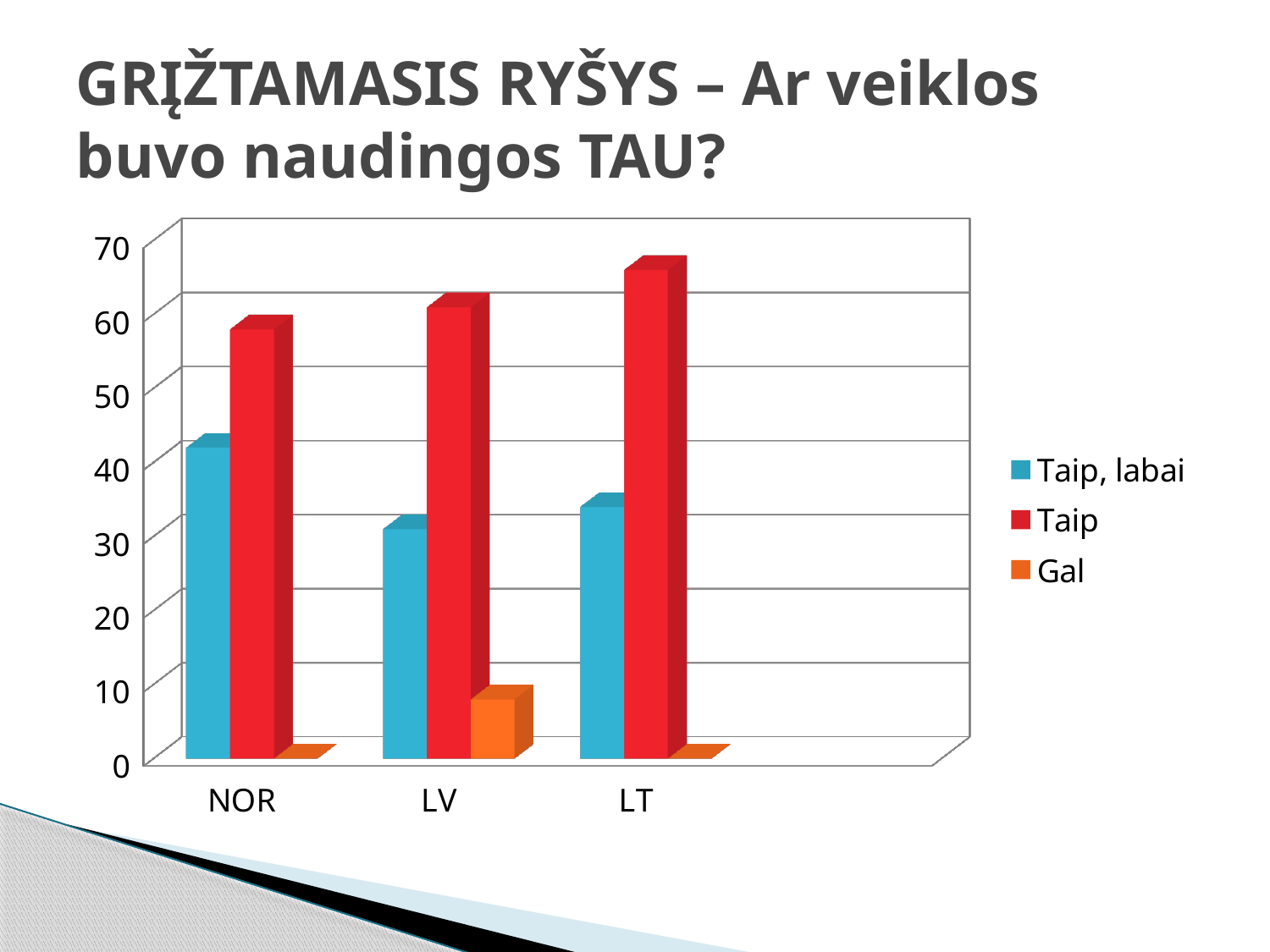
Is the "Taip" value for LT greater or less than 60? greater Is the "Taip, labai" value for NOR greater or less than 50? less Which category has the highest value for the "Taip" series? LT What kind of chart is shown on the slide? bar chart Which series has the lowest value for LV? Gal Which legend entry is shown in orange? Gal How many series does the chart legend list? 3 Is the "Gal" value for LV greater or less than 10? less Is the "Taip, labai" value for NOR larger or smaller than the "Taip, labai" value for LV? larger Which category has the lowest value for the "Taip, labai" series? LV Which series has the highest value for NOR? Taip How many categories are shown on the x axis of the chart? 3